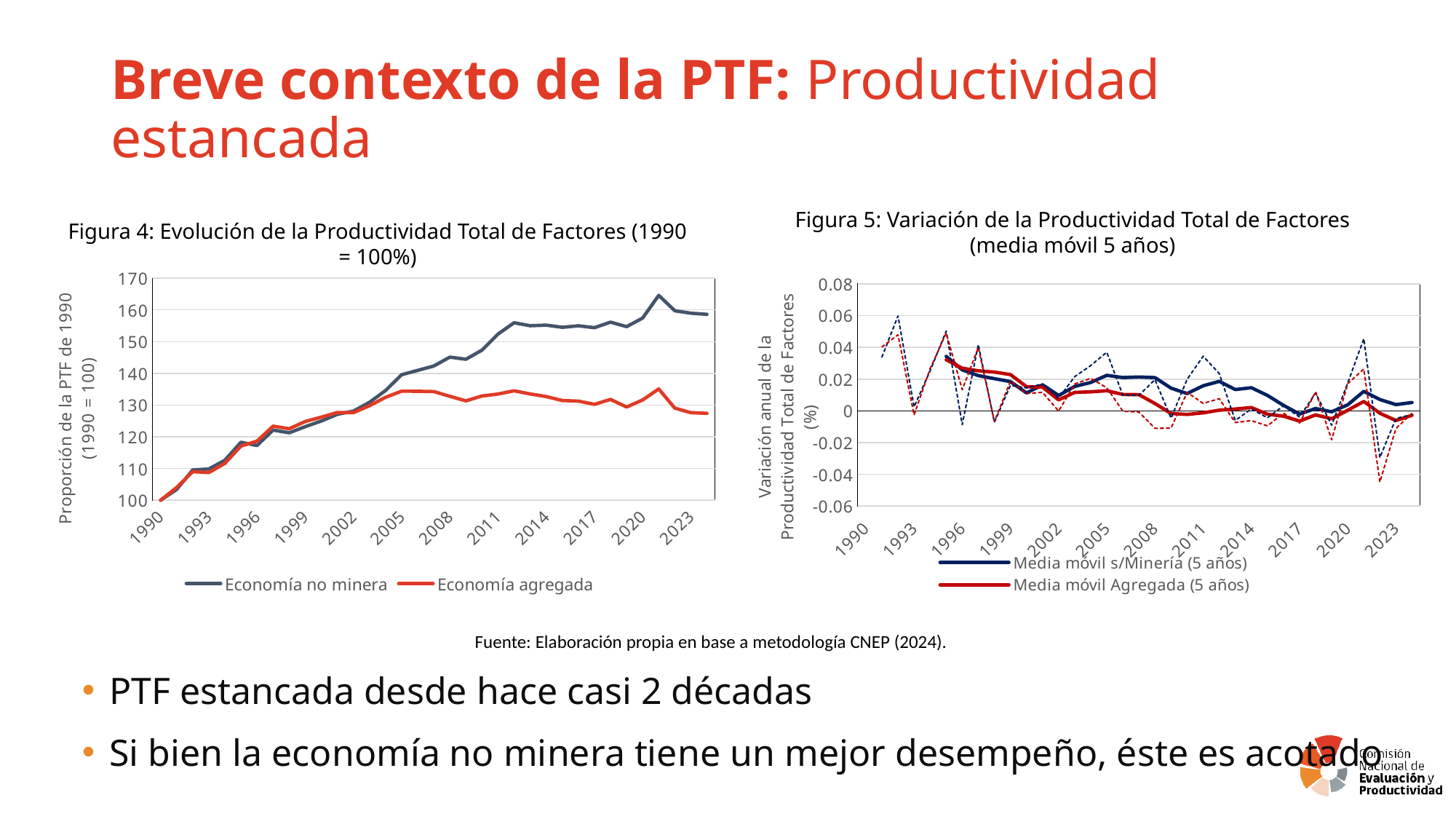
How many series does the legend of Figura 5 list? 2 In Figura 4, what is the value of Economía agregada in 1990? 100 In Figura 4, does the Economía no minera series rise or fall overall from 1990 to 2023? rise What kind of chart is Figura 4? line chart How many series does the legend of Figura 4 list? 2 What is the title of the chart on the left of the slide? Figura 4: Evolución de la Productividad Total de Factores (1990 = 100%) What kind of chart is Figura 5? line chart In Figura 5, is the value for Media móvil s/Minería (5 años) in 1996 greater or less than 0.02? greater In Figura 4, is the value for Economía agregada in 2023 greater or less than 130? less In Figura 5, does the Media móvil Agregada (5 años) series rise or fall overall from 1996 to 2023? fall In Figura 4, which series is higher in 2023, Economía no minera or Economía agregada? Economía no minera In Figura 4, is the value for Economía no minera in 2023 greater or less than 150? greater